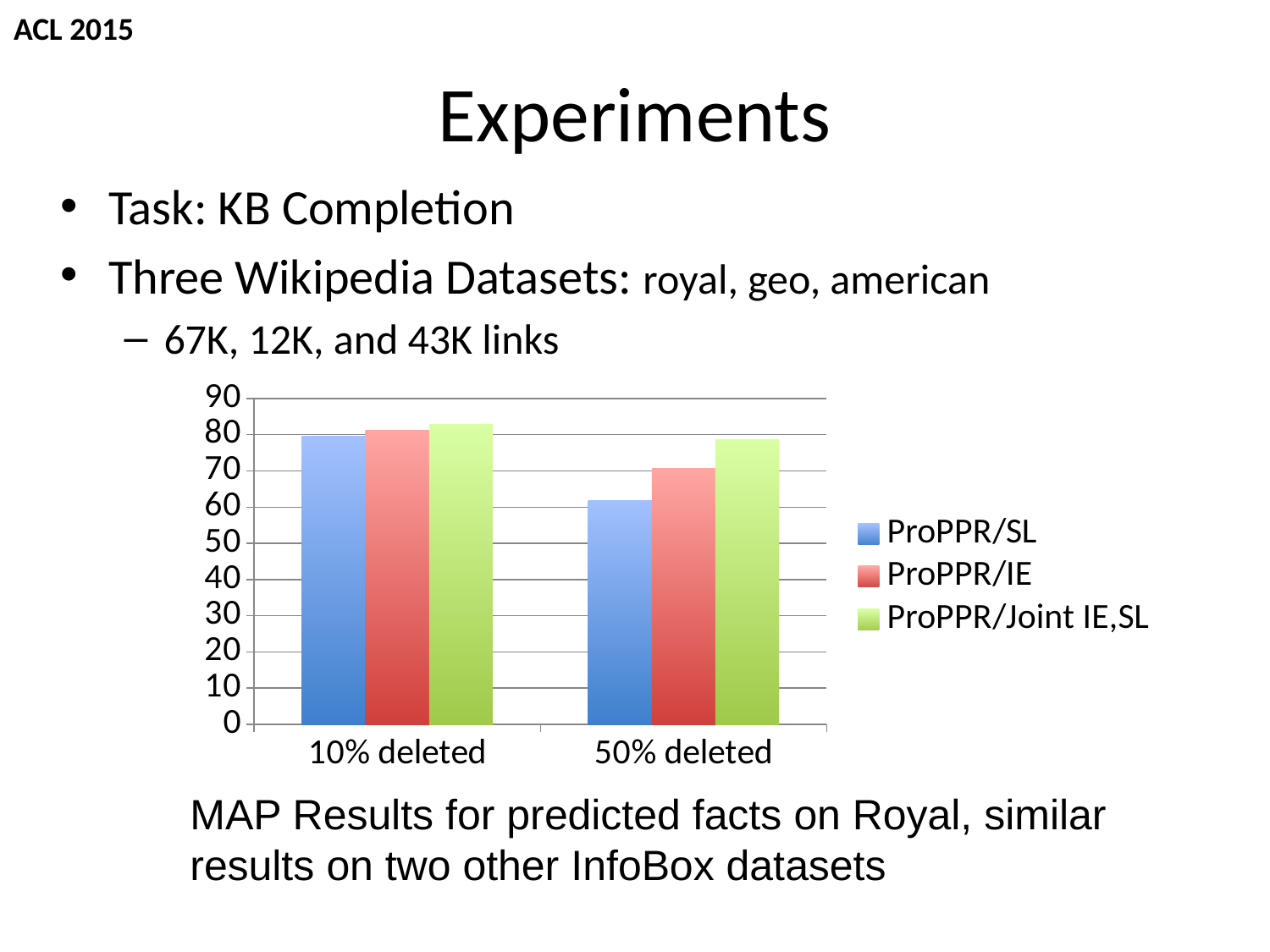
Which series is shown in green in the chart? ProPPR/Joint IE,SL Is the value for ProPPR/IE at 50% deleted greater or less than 60? greater Which series has the highest value in the 50% deleted category? ProPPR/Joint IE,SL Is the value for ProPPR/SL at 10% deleted greater or less than 70? greater Which series has the lowest value in the 50% deleted category? ProPPR/SL What kind of chart is shown on the slide? bar chart How many categories are shown on the x axis of the chart? 2 At 50% deleted, which is larger: the value for ProPPR/IE or the value for ProPPR/SL? ProPPR/IE Do the values for ProPPR/SL rise or fall from 10% deleted to 50% deleted? fall Is the value for ProPPR/Joint IE,SL at 50% deleted greater or less than 70? greater How many series does the chart legend list? 3